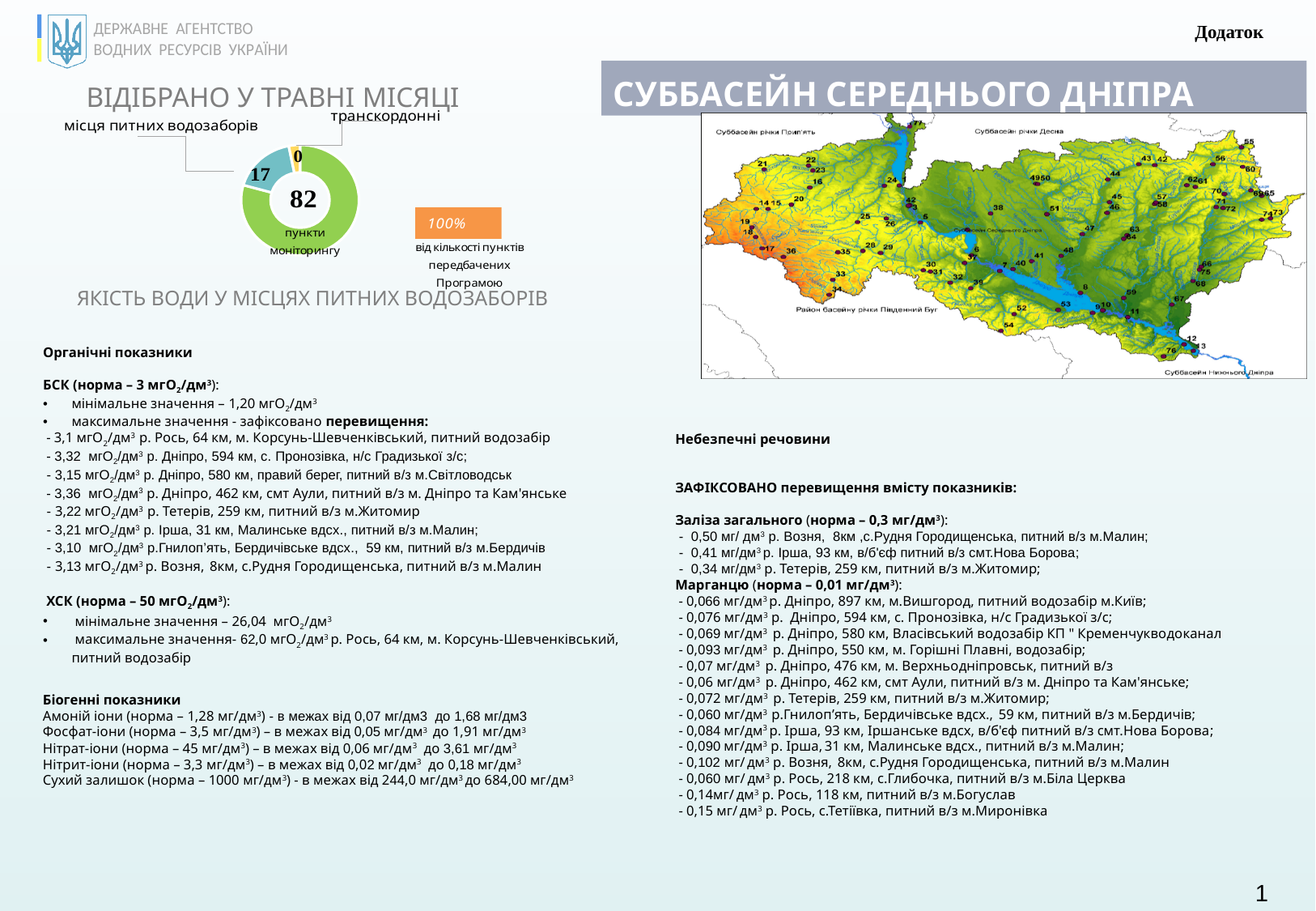
In the doughnut chart, which is larger: 'місця питних водозаборів' or 'транскордонні'? місця питних водозаборів How many categories are labelled with callouts on the doughnut chart? 2 In the doughnut chart, which labelled category has the lowest value? транскордонні In the doughnut chart, what is the difference between the values for 'місця питних водозаборів' and 'транскордонні'? 17 What is the title above the doughnut chart on the left of the slide? ВІДІБРАНО У ТРАВНІ МІСЯЦІ What kind of chart is shown under the heading 'ВІДІБРАНО У ТРАВНІ МІСЯЦІ'? doughnut (pie) chart In the doughnut chart 'ВІДІБРАНО У ТРАВНІ МІСЯЦІ', what value is shown for 'транскордонні'? 0 What number is printed in the centre of the doughnut chart 'ВІДІБРАНО У ТРАВНІ МІСЯЦІ'? 82 What does the number 82 in the centre of the doughnut chart refer to? пункти моніторингу What percentage is shown in the orange box next to the doughnut chart? 100% In the doughnut chart 'ВІДІБРАНО У ТРАВНІ МІСЯЦІ', what value is shown for 'місця питних водозаборів'? 17